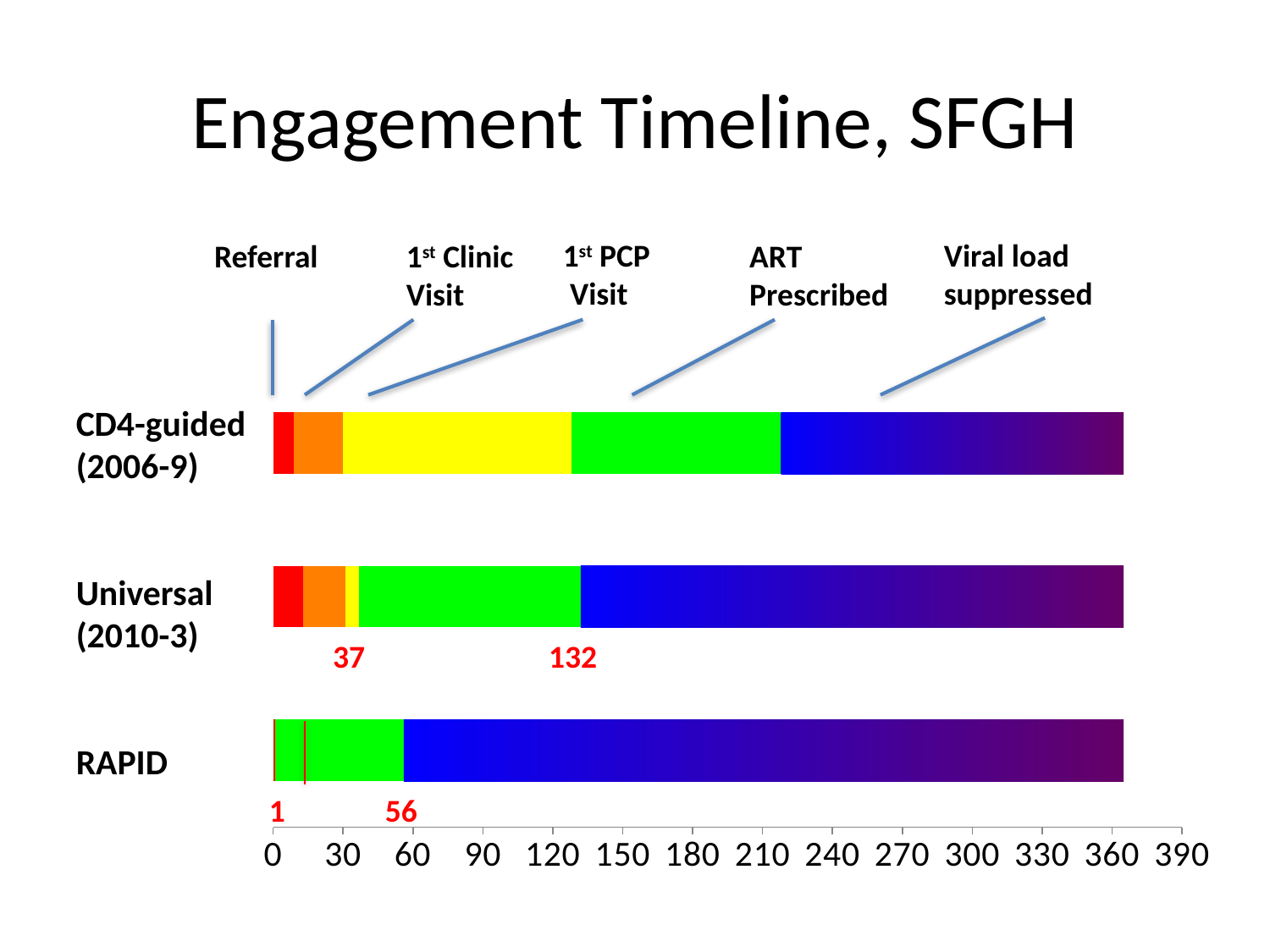
What is the difference in days to ART prescription between the Universal (2010-3) group and the RAPID group? 36 Is the day of ART prescription for the CD4-guided (2006-9) group greater or less than 90? greater How many days sooner was viral load suppressed in the RAPID group than in the Universal (2010-3) group? 76 Which group took the longest to reach viral load suppression? CD4-guided (2006-9) How many engagement stages are labelled above the bars? 5 On what day was viral load suppressed for the Universal (2010-3) group? 132 Which group reached viral load suppression sooner, Universal (2010-3) or RAPID? RAPID On what day was ART prescribed for the Universal (2010-3) group? 37 On what day was viral load suppressed for the RAPID group? 56 On what day was ART prescribed for the RAPID group? 1 What kind of chart is shown on the slide? bar chart How many groups (bars) are shown in the Engagement Timeline chart? 3